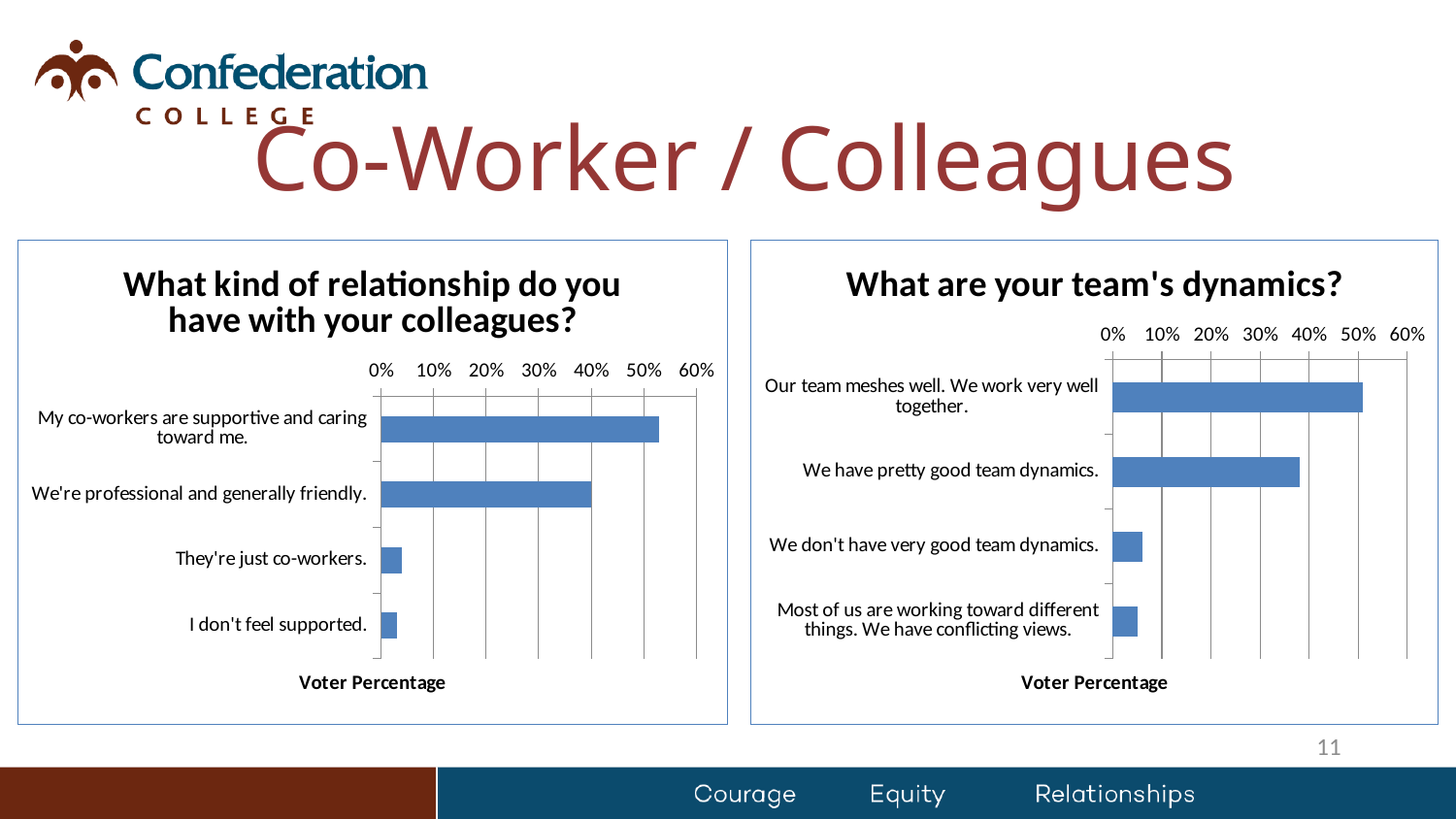
In the 'What kind of relationship do you have with your colleagues?' chart, is the value for 'My co-workers are supportive and caring toward me.' greater or less than 50%? greater In the 'What kind of relationship do you have with your colleagues?' chart, how many categories are shown? 4 In the 'What kind of relationship do you have with your colleagues?' chart, which is larger: 'We're professional and generally friendly.' or 'I don't feel supported.'? We're professional and generally friendly. In the 'What kind of relationship do you have with your colleagues?' chart, which category has the highest voter percentage? My co-workers are supportive and caring toward me. In the 'What are your team's dynamics?' chart, is the value for 'We have pretty good team dynamics.' greater or less than 30%? greater In the 'What kind of relationship do you have with your colleagues?' chart, is the value for 'They're just co-workers.' greater or less than 10%? less What kind of chart is used in the 'What kind of relationship do you have with your colleagues?' chart? bar chart In the 'What are your team's dynamics?' chart, which category has the highest voter percentage? Our team meshes well. We work very well together. In the 'What are your team's dynamics?' chart, how many categories are shown? 4 What is the x-axis label of the 'What are your team's dynamics?' chart? Voter Percentage In the 'What are your team's dynamics?' chart, which is larger: 'Our team meshes well. We work very well together.' or 'We have pretty good team dynamics.'? Our team meshes well. We work very well together.